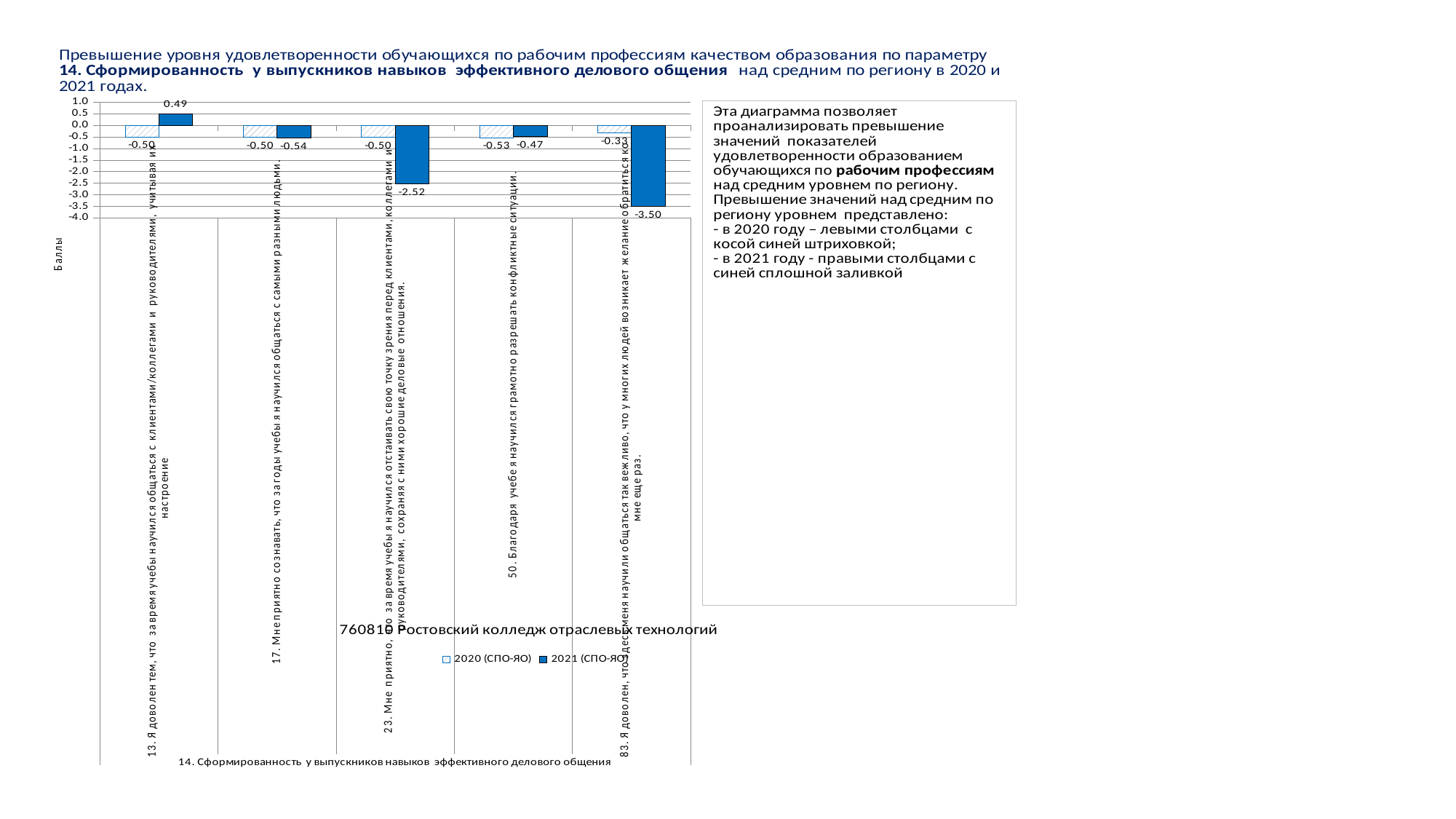
What is the 2021 (СПО-ЯО) value for statement 13 ("Я доволен тем, что за время учебы научился общаться с клиентами/коллегами и руководителями...")? 0.49 For statement 17, which series has the larger value: 2020 (СПО-ЯО) or 2021 (СПО-ЯО)? 2020 (СПО-ЯО) Which statement has the highest 2021 (СПО-ЯО) value? 13. Я доволен тем, что за время учебы научился общаться с клиентами/коллегами и руководителями, учитывая их настроение What is the 2021 (СПО-ЯО) value for statement 23 ("Мне приятно, что за время учебы я научился отстаивать свою точку зрения...")? -2.52 How many series does the chart legend list? 2 What kind of chart is shown on the slide? Bar chart Which statement has the lowest 2021 (СПО-ЯО) value? 83. Я доволен, что здесь меня научили общаться так вежливо, что у многих людей возникает желание обратиться ко мне еще раз. What is the 2021 (СПО-ЯО) value for statement 50 ("Благодаря учебе я научился грамотно разрешать конфликтные ситуации")? -0.47 What is the 2020 (СПО-ЯО) value for statement 83 ("Я доволен, что здесь меня научили общаться так вежливо...")? -0.33 How many statements (categories) are shown on the x axis of the chart? 5 What is the difference between the 2021 (СПО-ЯО) values for statement 83 and statement 23? 0.98 What is the label of the vertical axis of the chart? Баллы